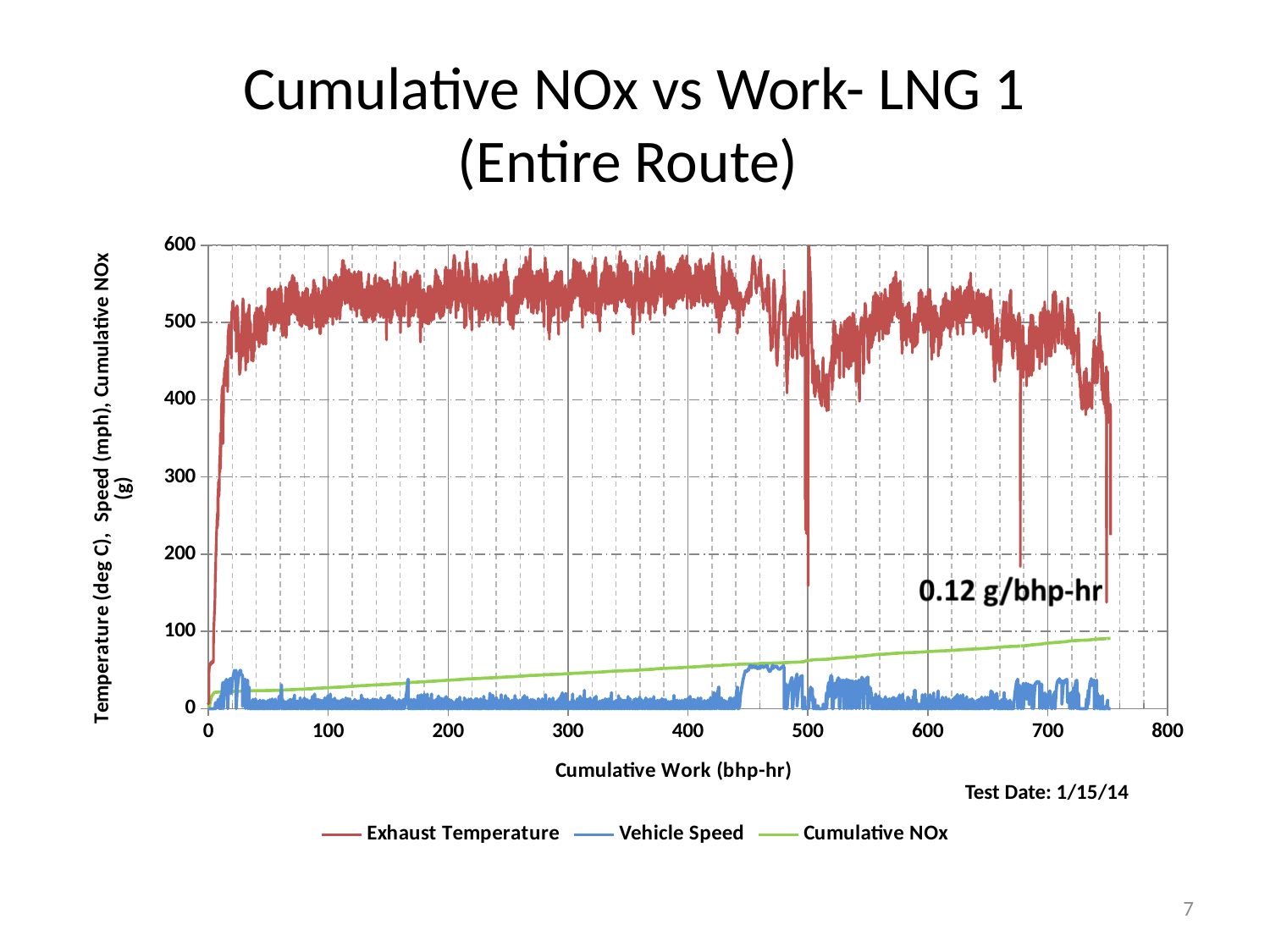
How many series does the legend list? 3 Does the Cumulative NOx series rise or fall as cumulative work increases? rise What kind of chart is shown on the slide? line chart What value is annotated on the chart in g/bhp-hr? 0.12 g/bhp-hr At 300 bhp-hr of cumulative work, which is larger: Exhaust Temperature or Vehicle Speed? Exhaust Temperature Which series reaches the highest values on the chart? Exhaust Temperature Is the Exhaust Temperature value at 100 bhp-hr of cumulative work greater or less than 400? greater Is the Exhaust Temperature value at 300 bhp-hr of cumulative work greater or less than 500? greater Is the Cumulative NOx value at 700 bhp-hr of cumulative work greater or less than 100? less What is the title of the chart? Cumulative NOx vs Work- LNG 1 (Entire Route)